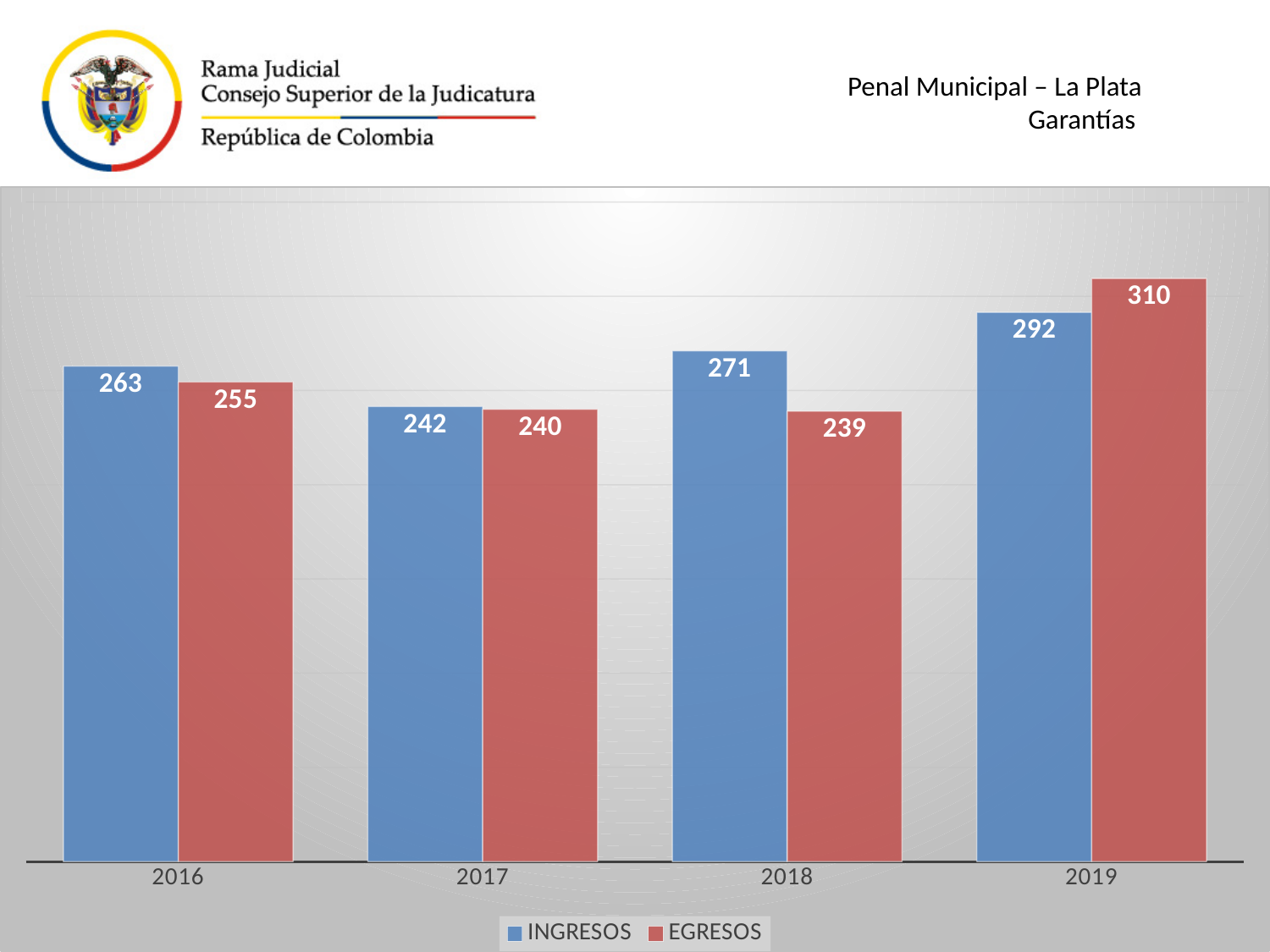
Which year has the lowest EGRESOS value? 2018 How many years are shown on the x axis? 4 Which colour represents EGRESOS in the chart? Red What is the EGRESOS value for 2016? 255 What is the EGRESOS value for 2019? 310 What is the difference between EGRESOS in 2019 and EGRESOS in 2016? 55 What is the INGRESOS value for 2018? 271 Which year has the highest INGRESOS value? 2019 How many series does the legend list? 2 Which is larger in 2019, INGRESOS or EGRESOS? EGRESOS What is the difference between INGRESOS and EGRESOS in 2018? 32 What kind of chart is shown on the slide? Bar chart